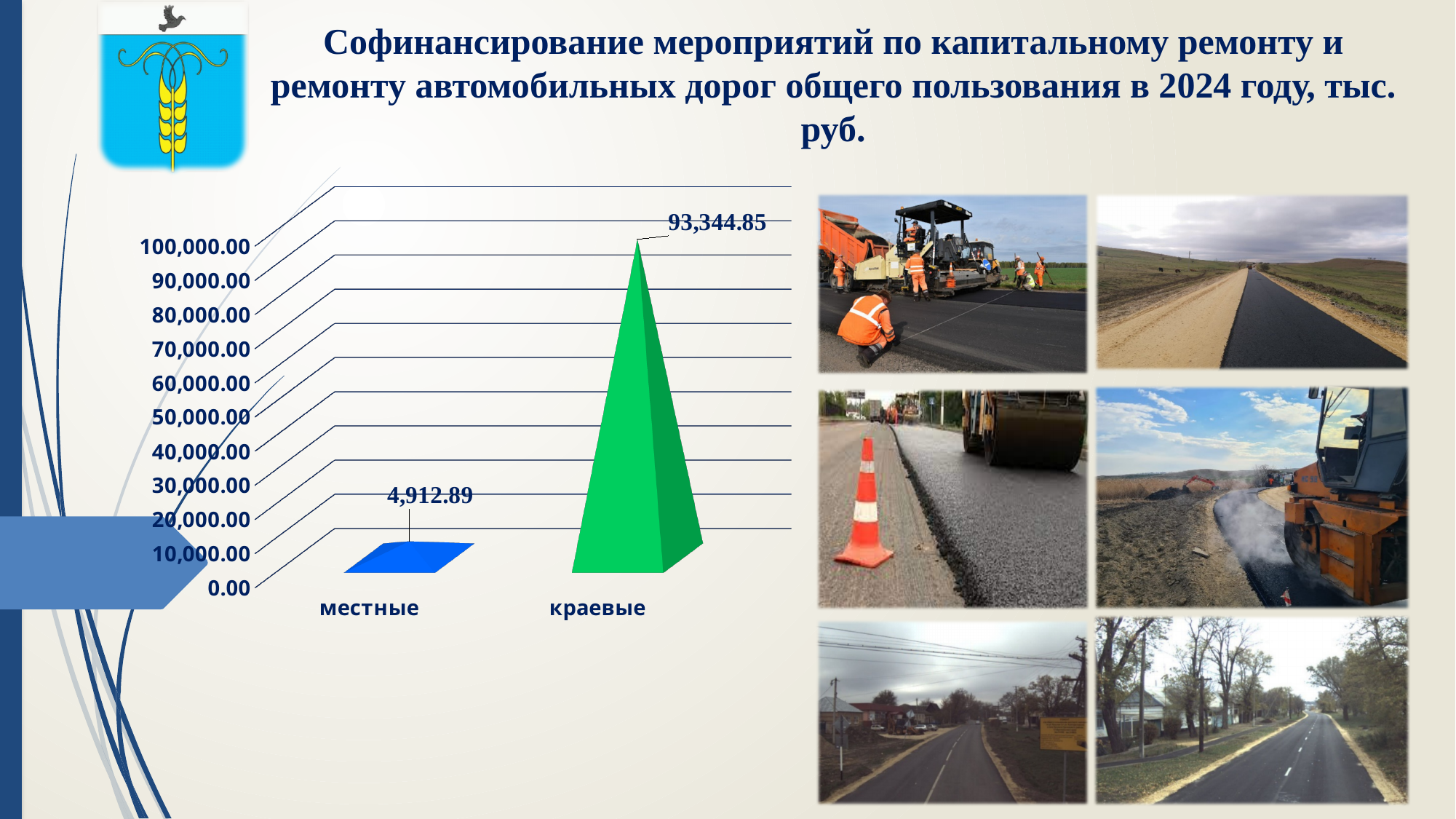
Which category has the lowest value? местные Which category has the highest value? краевые Is the value for местные greater or less than 10,000.00? less Which is larger, the value for местные or the value for краевые? краевые What is the value for местные? 4,912.89 What is the highest value labelled on the vertical axis of the chart? 100,000.00 Is the value for краевые greater or less than 90,000.00? greater What kind of chart is shown on the slide? bar chart What colour is the bar for краевые? green How many categories are shown on the x axis of the chart? 2 What is the value for краевые? 93,344.85 What is the difference between the values for краевые and местные? 88,431.96